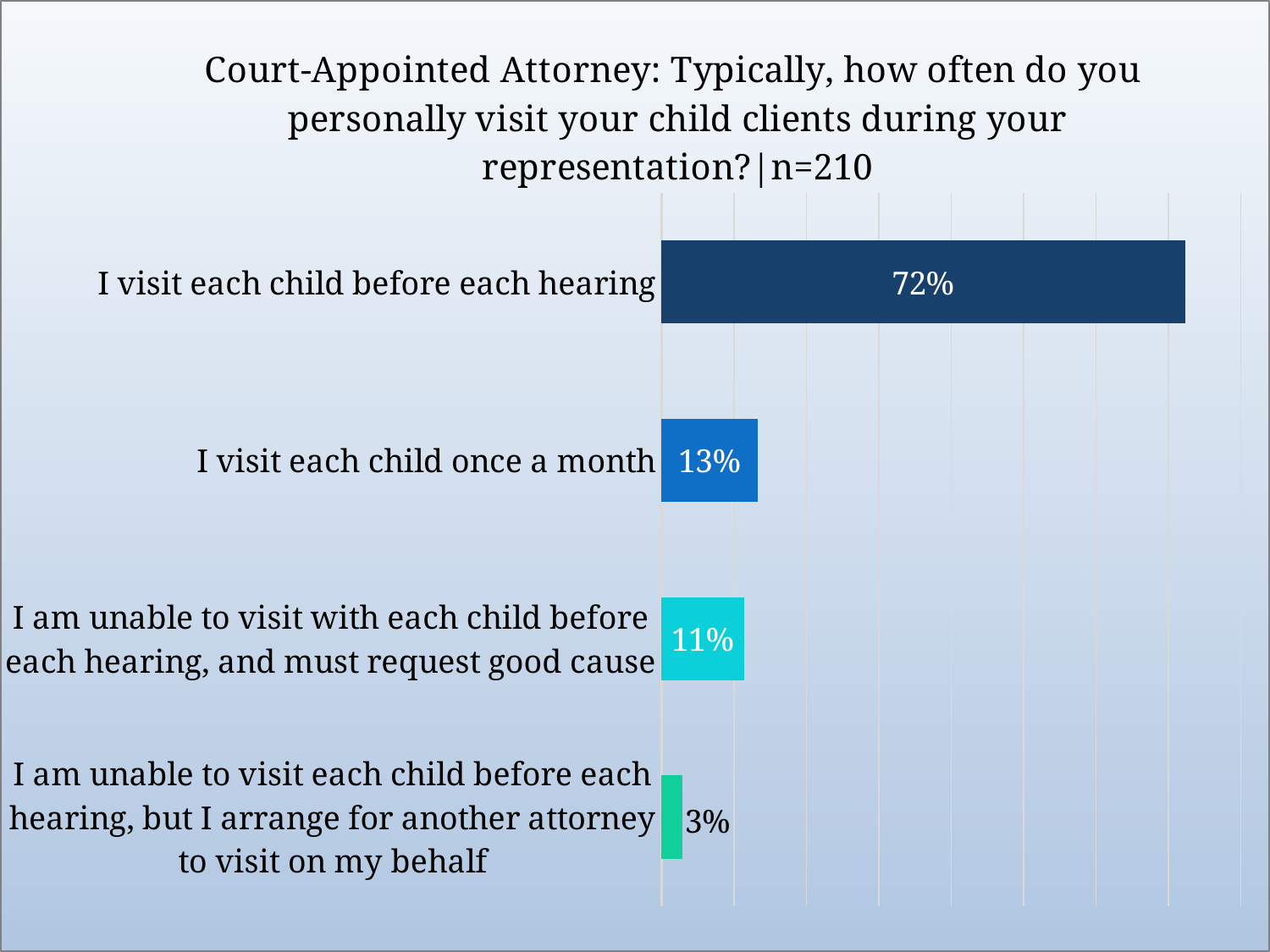
Which response option has the highest percentage? I visit each child before each hearing How many response options are shown in the chart? 4 What is the sample size (n) stated in the chart title? 210 Which response option has the lowest percentage? I am unable to visit each child before each hearing, but I arrange for another attorney to visit on my behalf What is the difference in percentage points between 'I visit each child before each hearing' and 'I visit each child once a month'? 59 What type of chart is shown on the slide? Bar chart Which is larger: the percentage for 'I visit each child once a month' or for 'I am unable to visit each child before each hearing, but I arrange for another attorney to visit on my behalf'? I visit each child once a month What percentage of respondents said they visit each child once a month? 13% What percentage of respondents said they arrange for another attorney to visit on their behalf? 3% What is the difference in percentage points between 'I visit each child once a month' and 'I am unable to visit with each child before each hearing, and must request good cause'? 2 What percentage of respondents said they visit each child before each hearing? 72% What percentage of respondents said they are unable to visit with each child before each hearing and must request good cause? 11%